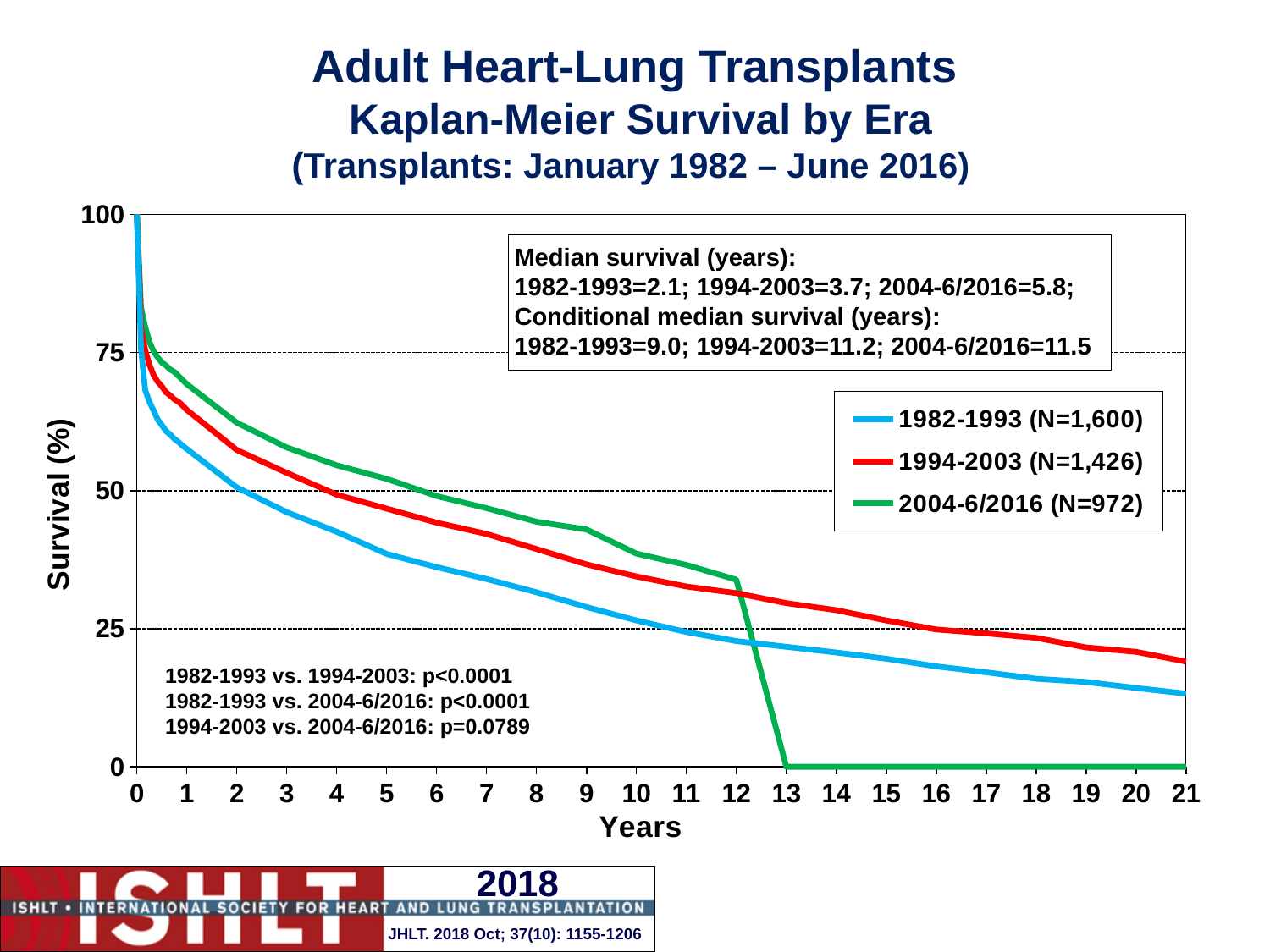
Which era has the lowest survival at year 10? 1982-1993 At year 5, which era has higher survival: 1982-1993 or 1994-2003? 1994-2003 Is the survival value for 1982-1993 at year 20 greater or less than 25? less What is the conditional median survival in years for the 1994-2003 era? 11.2 Is the survival value for 1982-1993 at year 5 greater or less than 50? less Which era has the highest survival at year 10? 2004-6/2016 What kind of chart is shown on the slide? line chart What is the N shown in the legend for the 2004-6/2016 era? 972 Is the survival value for 1994-2003 at year 10 greater or less than 25? greater How many series does the legend list? 3 What is the median survival in years for the 2004-6/2016 era? 5.8 Do the survival curves rise or fall as years increase along the x axis? fall